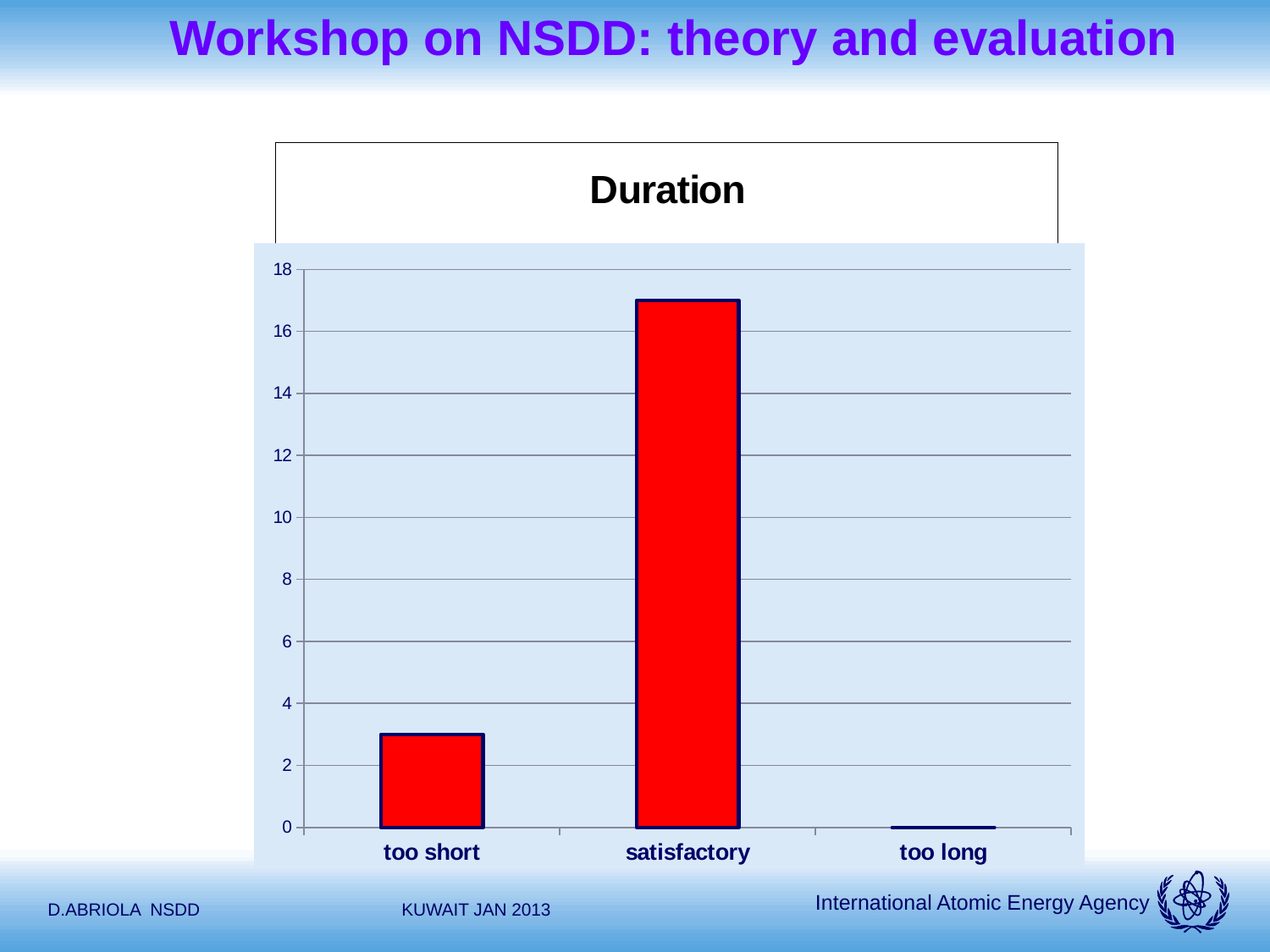
Is the value for 'too short' greater or less than 2? greater Is the value for 'too short' greater or less than 4? less What is the title of the chart? Duration What kind of chart is shown on the slide? bar chart What is the value for 'too long' in the Duration chart? 0 What is the highest value shown on the y axis of the Duration chart? 18 Which is larger in the Duration chart, the value for 'too short' or the value for 'satisfactory'? satisfactory How many categories are shown on the x axis of the Duration chart? 3 Is the value for 'satisfactory' greater or less than 16? greater Which is larger in the Duration chart, the value for 'too short' or the value for 'too long'? too short Which category has the lowest value in the Duration chart? too long Which category has the highest value in the Duration chart? satisfactory